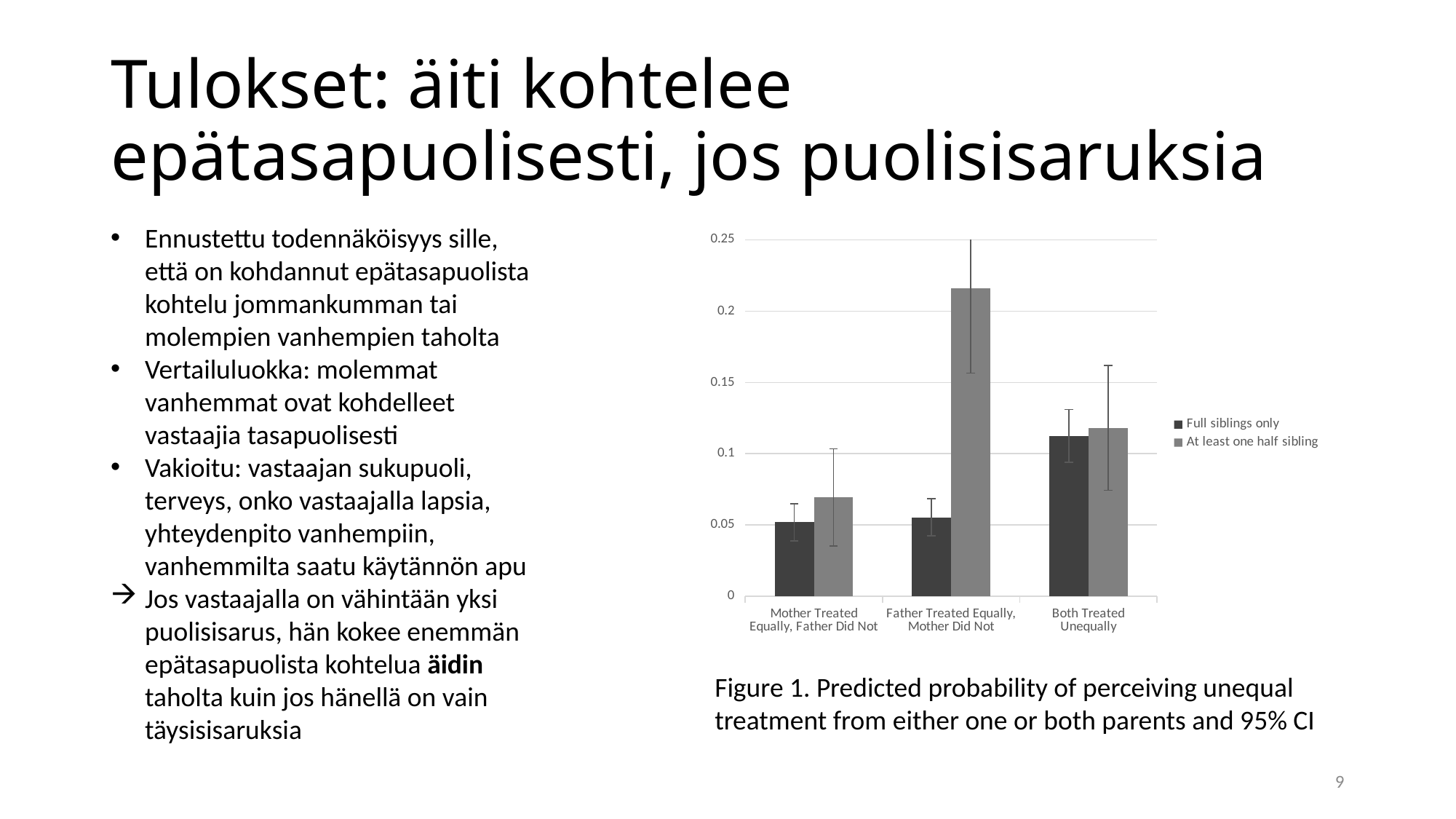
Which category has the lowest value for the 'At least one half sibling' series? Mother Treated Equally, Father Did Not Is the value for 'At least one half sibling' in the 'Mother Treated Equally, Father Did Not' category greater or less than 0.05? greater How many categories are shown on the x axis? 3 Which category has the highest value for the 'At least one half sibling' series? Father Treated Equally, Mother Did Not How many series does the legend list? 2 For 'Father Treated Equally, Mother Did Not', which series has the larger value: 'Full siblings only' or 'At least one half sibling'? At least one half sibling For 'Mother Treated Equally, Father Did Not', which series has the larger value: 'Full siblings only' or 'At least one half sibling'? At least one half sibling Is the value for 'At least one half sibling' in the 'Father Treated Equally, Mother Did Not' category greater or less than 0.2? greater Which category has the highest value for the 'Full siblings only' series? Both Treated Unequally Is the value for 'Full siblings only' in the 'Mother Treated Equally, Father Did Not' category greater or less than 0.1? less What kind of chart is shown on the slide? Bar chart What is the caption of the figure shown on the slide? Figure 1. Predicted probability of perceiving unequal treatment from either one or both parents and 95% CI